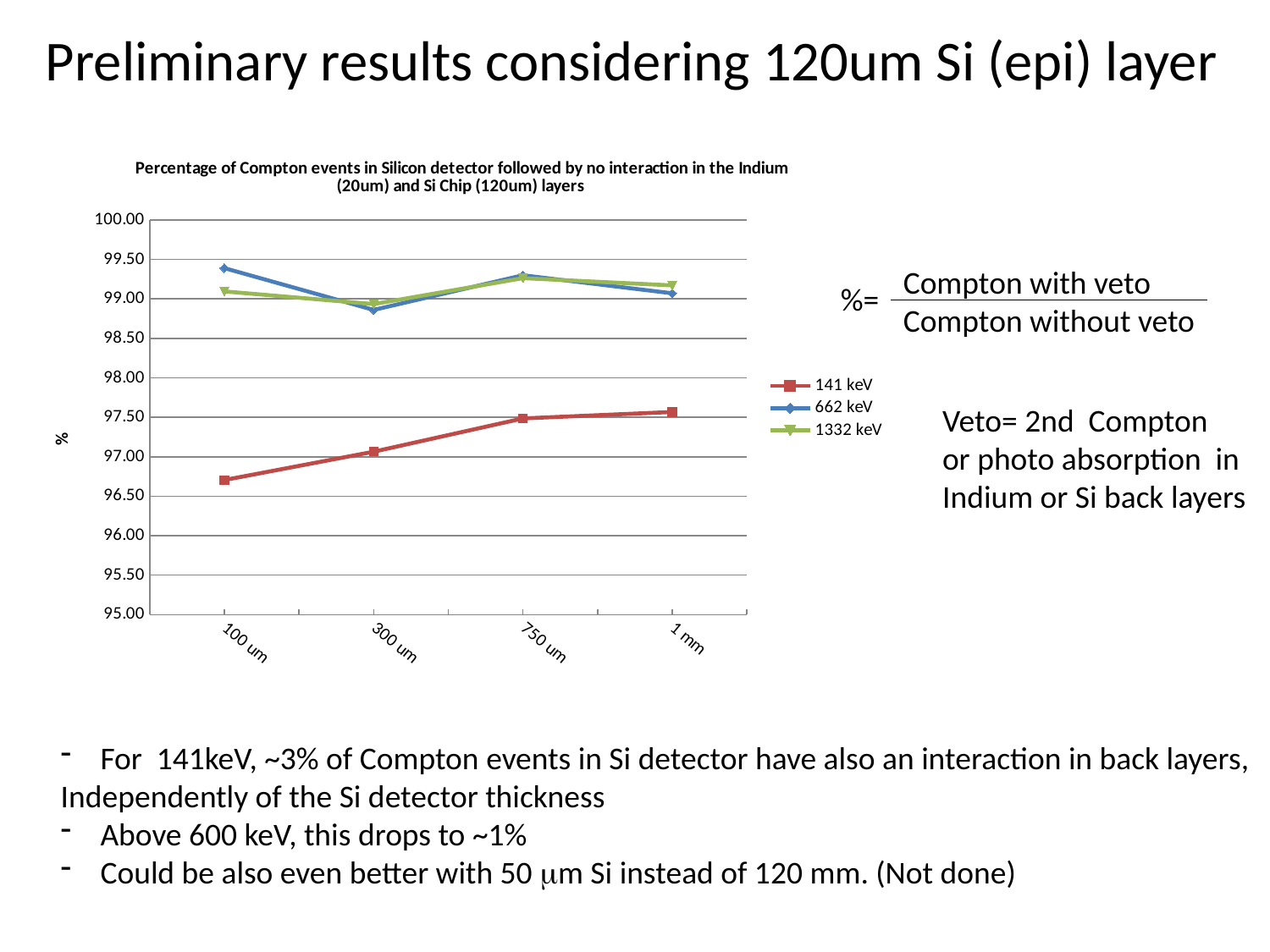
At 300 um, which is larger: the value for 662 keV or the value for 141 keV? 662 keV Which series is lowest at 1 mm? 141 keV How many thickness categories are plotted along the x axis? 4 How many series does the legend list? 3 Does the 141 keV series rise or fall from 100 um to 1 mm? rise Is the value for 141 keV at 100 um greater or less than 97.00? less Which series is lowest at 100 um? 141 keV Is the value for 662 keV at 100 um greater or less than 99.00? greater Is the value for 1332 keV at 100 um greater or less than 98.50? greater What is the label on the y axis of the chart? % What kind of chart is shown on the slide? line chart